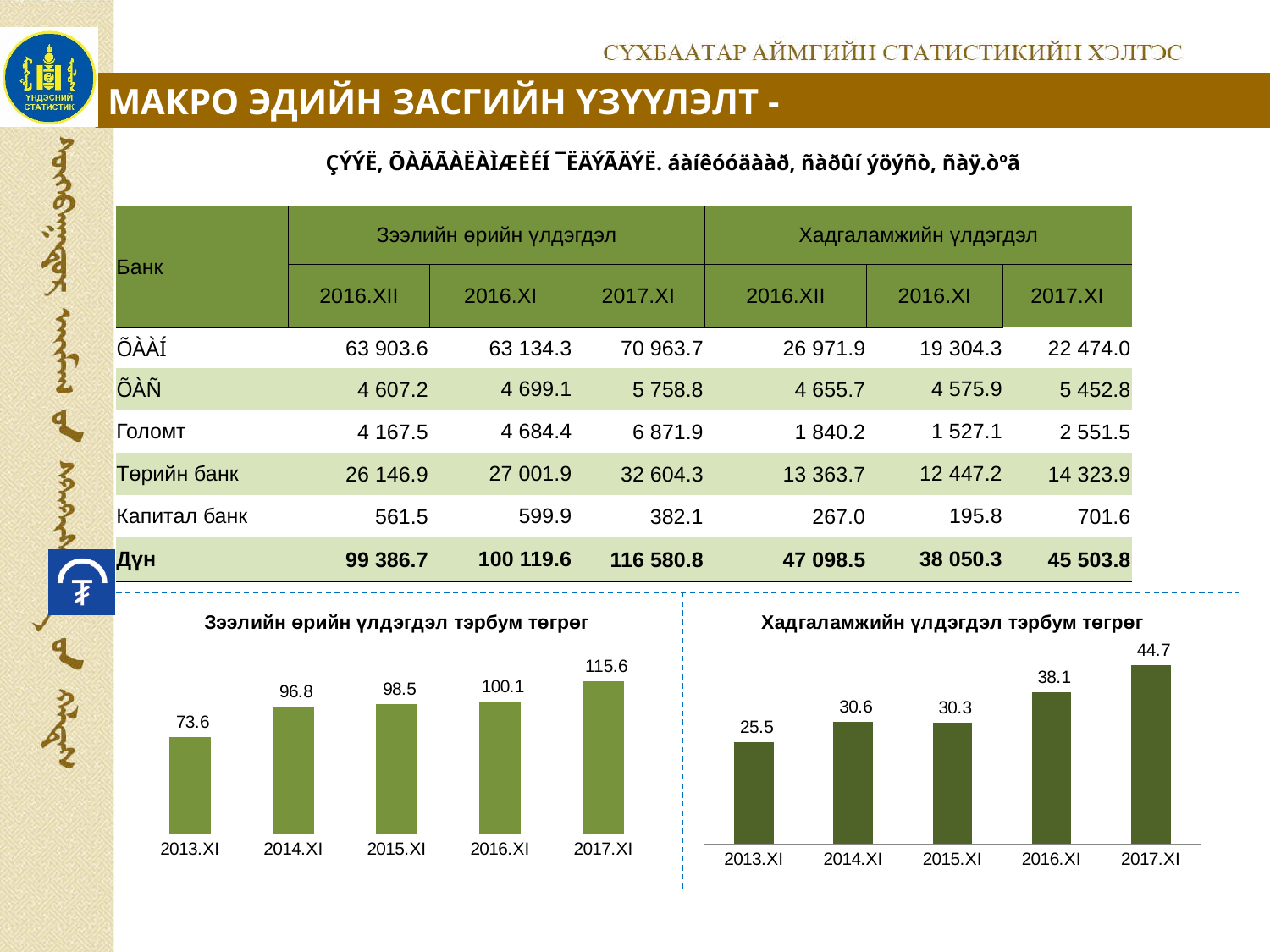
In the right chart (Хадгаламжийн үлдэгдэл тэрбум төгрөг), what is the value for 2016.XI? 38.1 How many periods are shown on the x axis of the left chart (Зээлийн өрийн үлдэгдэл тэрбум төгрөг)? 5 In the left chart (Зээлийн өрийн үлдэгдэл тэрбум төгрөг), what is the difference between the values for 2017.XI and 2016.XI? 15.5 In the left chart (Зээлийн өрийн үлдэгдэл тэрбум төгрөг), what is the value for 2013.XI? 73.6 What kind of chart is the right chart (Хадгаламжийн үлдэгдэл тэрбум төгрөг)? Bar chart What is the title of the right chart on the slide? Хадгаламжийн үлдэгдэл тэрбум төгрөг In the left chart (Зээлийн өрийн үлдэгдэл тэрбум төгрөг), do the values generally rise or fall from 2013.XI to 2017.XI? Rise In the left chart (Зээлийн өрийн үлдэгдэл тэрбум төгрөг), what is the value for 2017.XI? 115.6 In the right chart (Хадгаламжийн үлдэгдэл тэрбум төгрөг), which period has the lowest value? 2013.XI In the right chart (Хадгаламжийн үлдэгдэл тэрбум төгрөг), which is larger: the value for 2014.XI or 2015.XI? 2014.XI In the left chart (Зээлийн өрийн үлдэгдэл тэрбум төгрөг), which period has the highest value? 2017.XI In the right chart (Хадгаламжийн үлдэгдэл тэрбум төгрөг), what is the difference between the values for 2017.XI and 2013.XI? 19.2